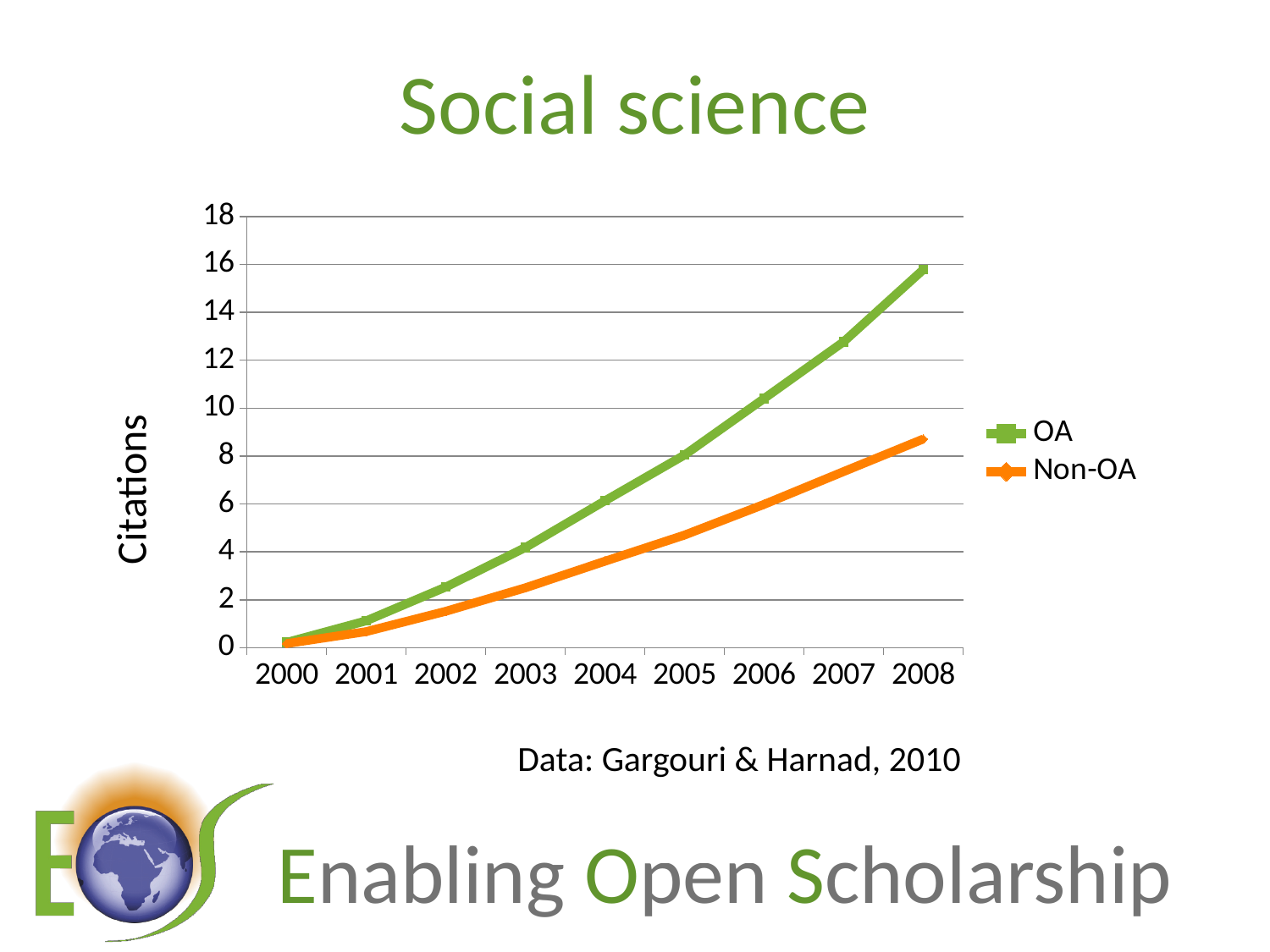
In which year is the Non-OA series at its lowest? 2000 What is the label on the y axis of the chart? Citations How many series does the legend list? 2 What kind of chart is shown on the slide? line chart Is the OA value for 2007 greater or less than 12? greater Do the OA citations rise or fall from 2000 to 2008? rise Is the Non-OA value for 2005 greater or less than 6? less Which series has the larger value in 2008, OA or Non-OA? OA Is the OA value for 2008 greater or less than 14? greater In which year does the OA series reach its highest value? 2008 How many years are shown along the x axis? 9